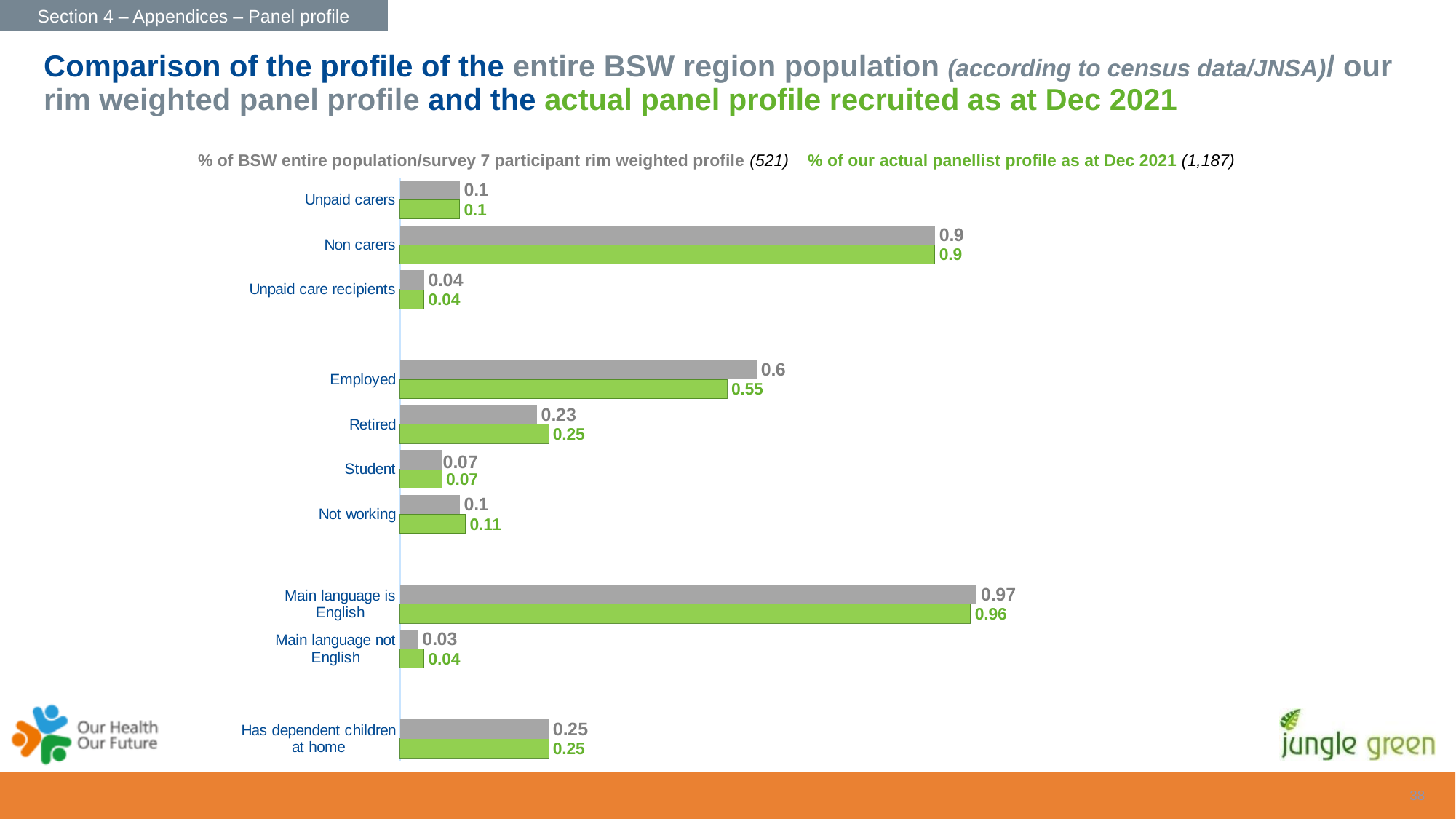
What colour are the bars for the '% of our actual panellist profile as at Dec 2021' series? Green Which category has the lowest value in the '% of BSW entire population/survey 7 participant rim weighted profile' series? Main language not English How many series does the chart legend list? 2 What is the value for Employed in the '% of BSW entire population/survey 7 participant rim weighted profile' series? 0.6 What kind of chart is shown on the slide? Bar chart What is the difference between the rim weighted profile value and the actual panellist profile value for Employed? 0.05 What is the value for Main language not English in the '% of BSW entire population/survey 7 participant rim weighted profile' series? 0.03 What is the value for Retired in the '% of our actual panellist profile as at Dec 2021' series? 0.25 What is the value for Employed in the '% of our actual panellist profile as at Dec 2021' series? 0.55 Which category has the highest value in the '% of our actual panellist profile as at Dec 2021' series? Main language is English For Not working, which series has the larger value: the rim weighted profile or the actual panellist profile? Actual panellist profile How many categories are plotted in the chart? 10